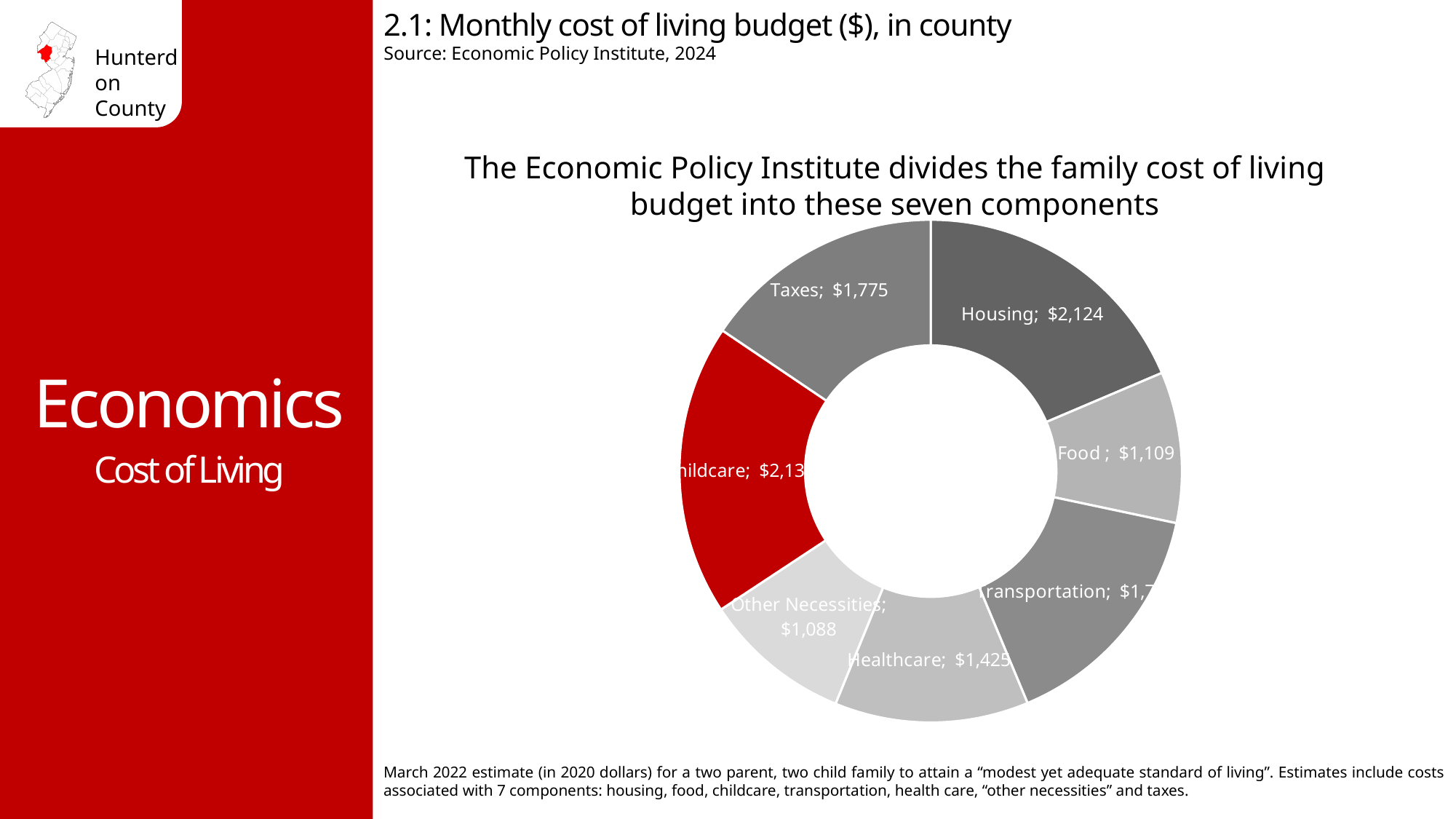
What is the difference between the Healthcare cost and the Food cost? $316 What is the monthly Housing cost shown on the chart? $2,124 How many budget components are shown in the chart? 7 What is the source cited for the chart? Economic Policy Institute, 2024 What is the monthly Healthcare cost shown on the chart? $1,425 Which is larger, the Housing cost or the Taxes cost? Housing What is the difference between the Housing cost and the Taxes cost? $349 Which is larger, the Healthcare cost or the Food cost? Healthcare What is the monthly Food cost shown on the chart? $1,109 What is the monthly Taxes value shown on the chart? $1,775 What kind of chart is used to show the monthly cost of living budget? Doughnut (pie) chart What is the monthly Other Necessities cost shown on the chart? $1,088